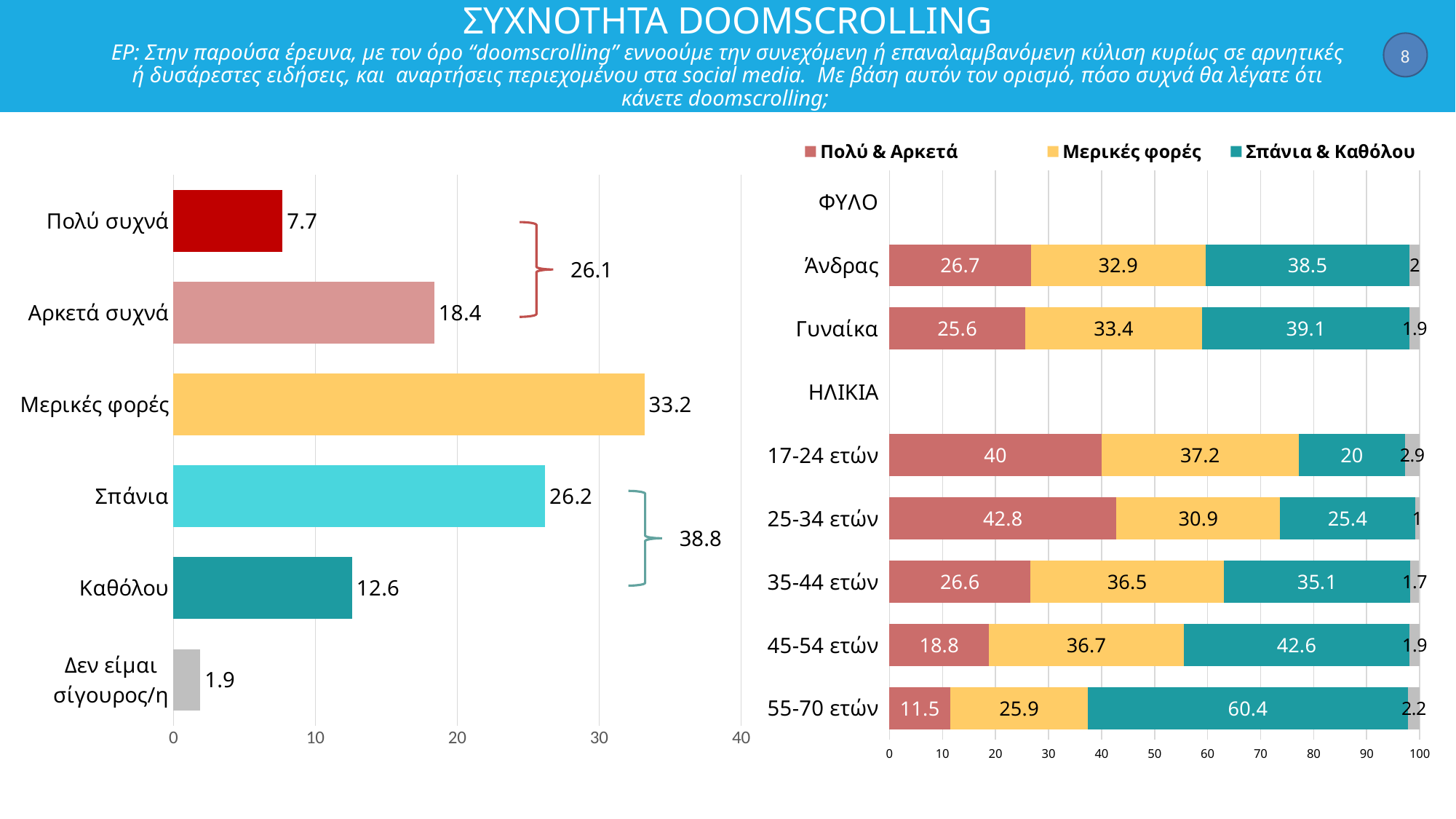
In the left bar chart, which category has the lowest value? Δεν είμαι σίγουρος/η In the right stacked bar chart, what is the Πολύ & Αρκετά value for 25-34 ετών? 42.8 In the right stacked bar chart, is the Μερικές φορές value larger for Άνδρας or Γυναίκα? Γυναίκα In the left bar chart, how many categories are shown? 6 How many series does the legend of the right stacked bar chart list? 3 In the right stacked bar chart, what is the Σπάνια & Καθόλου value for 55-70 ετών? 60.4 In the left bar chart, what is the difference between the values for Σπάνια and Καθόλου? 13.6 In the right stacked bar chart, what is the difference between the Σπάνια & Καθόλου values for 45-54 ετών and 17-24 ετών? 22.6 In the left bar chart, what is the value for Μερικές φορές? 33.2 In the right stacked bar chart, which age group has the highest Πολύ & Αρκετά value? 25-34 ετών What kind of chart is the chart on the left? Bar chart In the left bar chart, which category has the highest value? Μερικές φορές